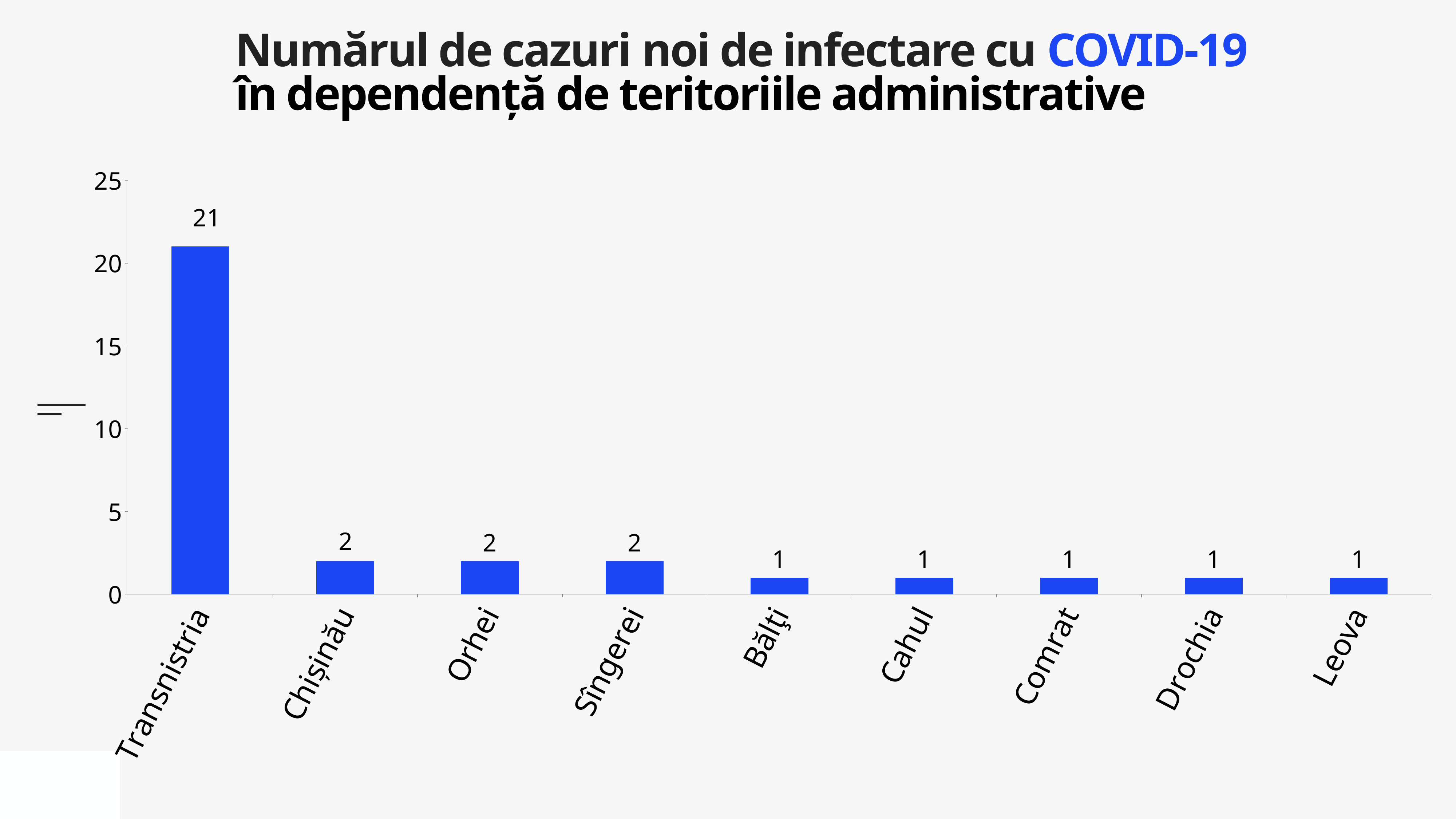
What is the value for Transnistria? 21 What is the value for Chișinău? 2 Which is larger, the value for Transnistria or the value for Chișinău? Transnistria What is the difference between the values for Sîngerei and Bălţi? 1 What is the value for Cahul? 1 Is the value for Transnistria greater or less than 20? greater Which is larger, the value for Orhei or the value for Drochia? Orhei How many categories are shown on the x axis? 9 Which category has the highest value? Transnistria What kind of chart is shown on the slide? bar chart What is the value for Leova? 1 What is the difference between the values for Transnistria and Orhei? 19